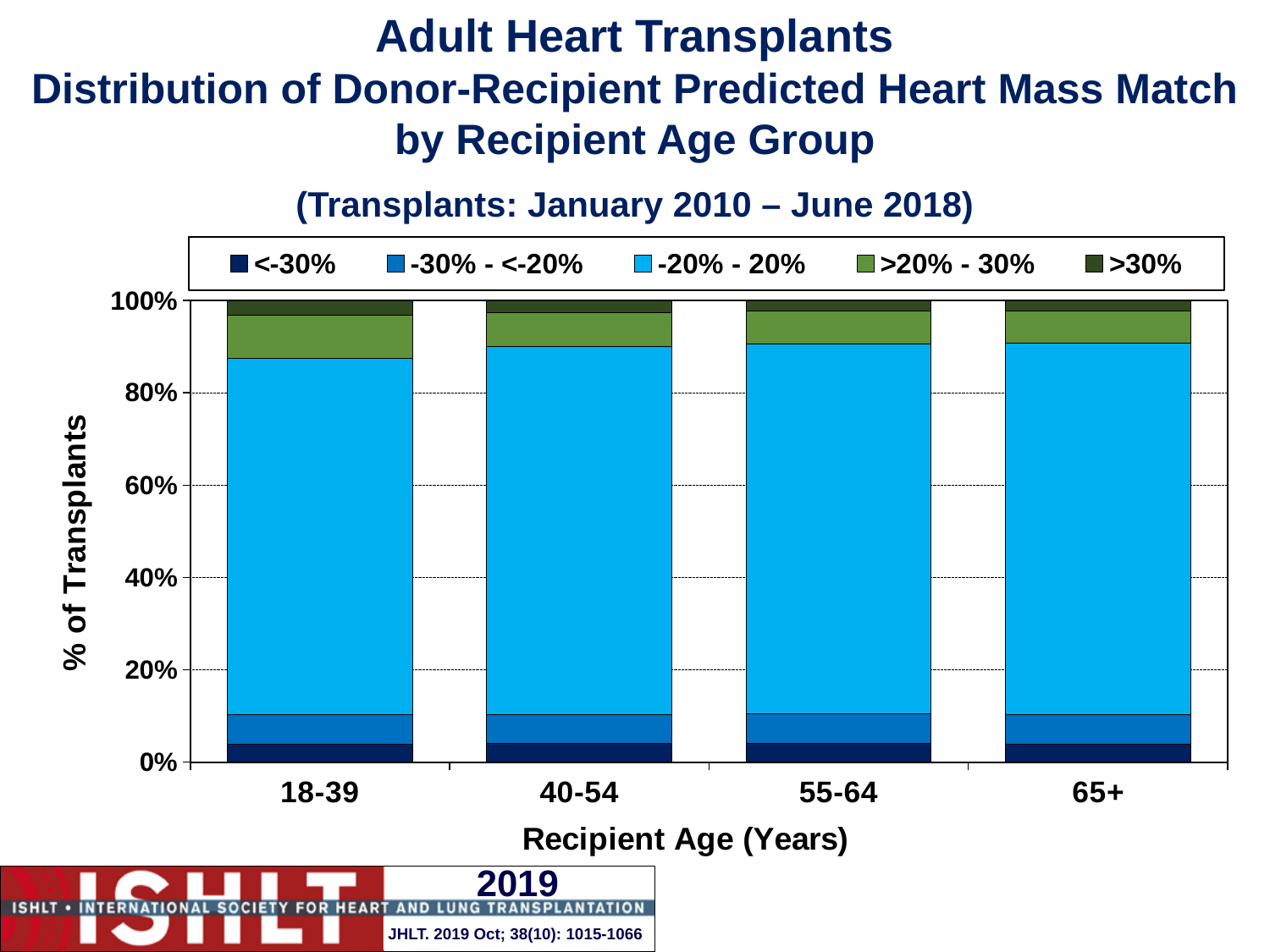
Which series makes up the largest share of each bar across all age groups? -20% - 20% In the 65+ age group, which is larger: the >20% - 30% segment or the -20% - 20% segment? -20% - 20% What is the label of the y axis? % of Transplants What is the label of the x axis? Recipient Age (Years) Is the value for the >30% series in the 55-64 age group greater or less than 20%? less How many recipient age groups are shown on the x axis? 4 What is the total height of the stacked bar for the 18-39 age group? 100% Is the value for the -20% - 20% series in the 18-39 age group greater or less than 60%? greater In the 40-54 age group, which is larger: the -20% - 20% segment or the <-30% segment? -20% - 20% How many series does the legend list? 5 Is the value for the <-30% series in the 65+ age group greater or less than 20%? less What kind of chart is shown on the slide? Stacked bar chart